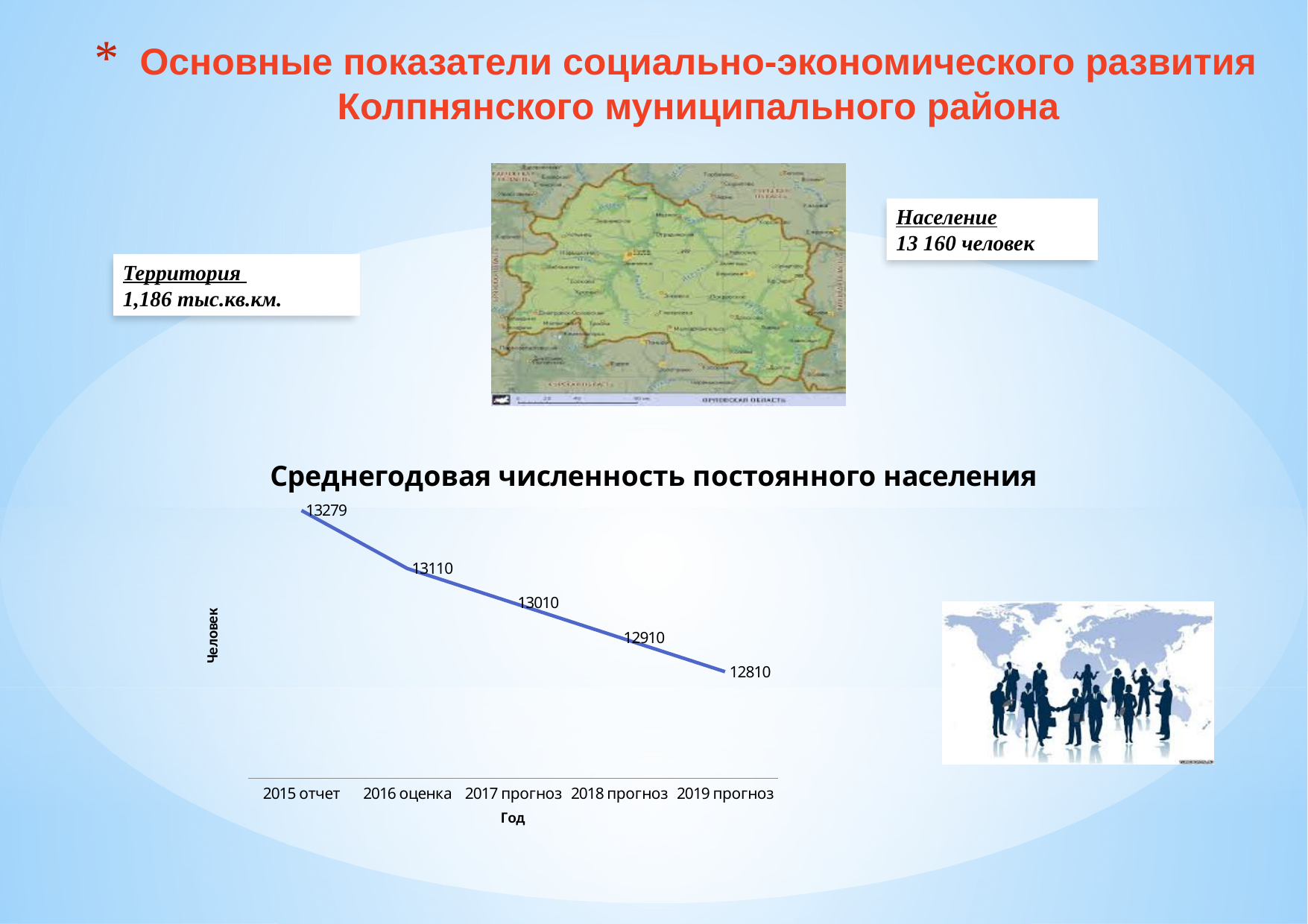
What is the value for 2017 прогноз in the chart? 13010 Which year has the highest value in the chart? 2015 отчет What is the value for 2019 прогноз in the chart? 12810 What is the value for 2015 отчет in the chart? 13279 What is the difference between the values for 2015 отчет and 2016 оценка? 169 What type of chart is used to show the average annual permanent population? line chart Which is larger, the value for 2016 оценка or the value for 2018 прогноз? 2016 оценка What is the difference between the values for 2018 прогноз and 2019 прогноз? 100 Which year has the lowest value in the chart? 2019 прогноз What is the title of the chart? Среднегодовая численность постоянного населения How many data points are plotted in the chart? 5 Do the values rise or fall from 2015 to 2019 along the x axis? fall